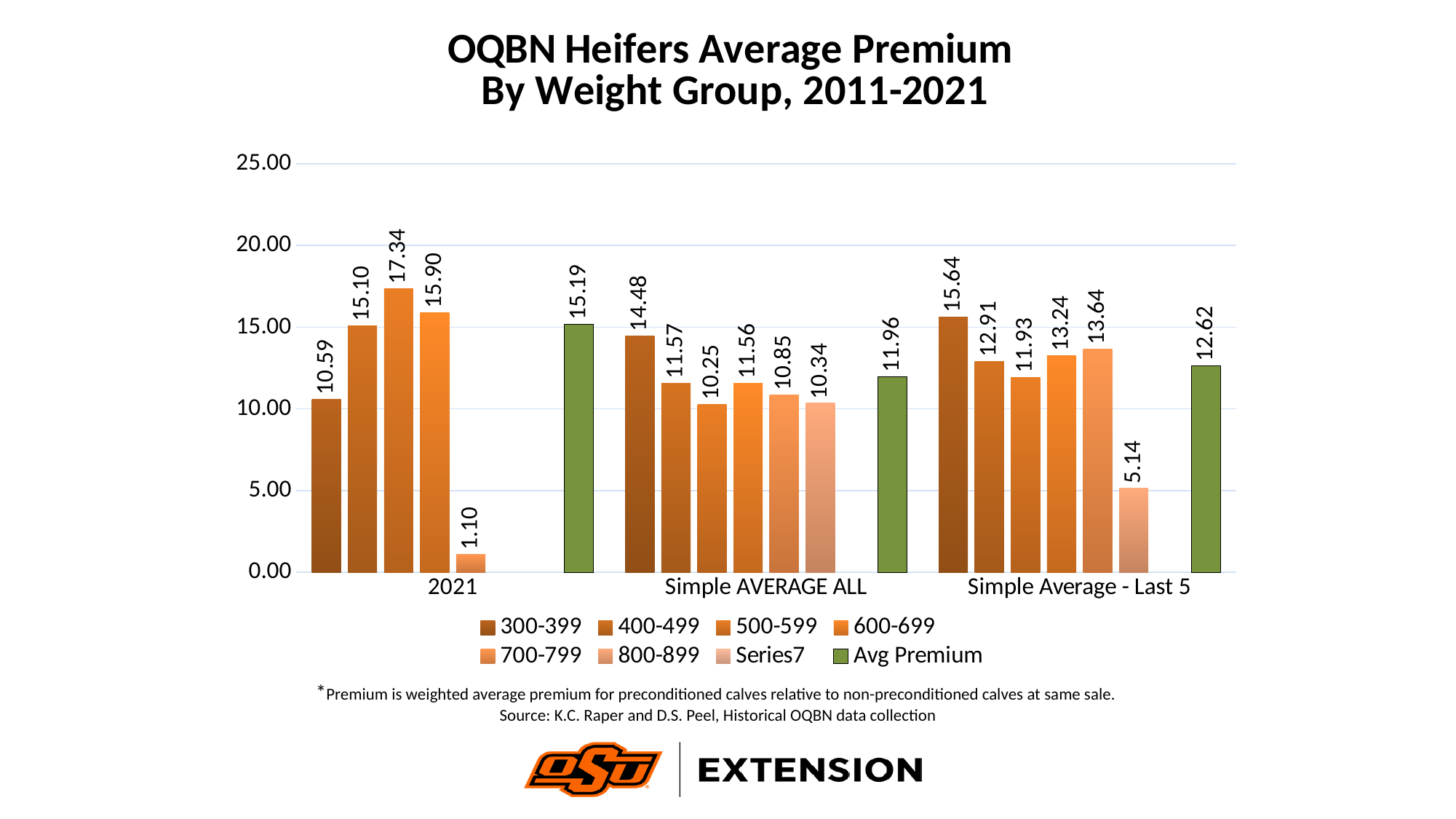
What is the Avg Premium value for Simple AVERAGE ALL? 11.96 What is the lowest value shown in the 2021 group? 1.10 What is the Avg Premium value for Simple Average - Last 5? 12.62 What kind of chart is shown on the slide? bar chart Which is larger: the 300-399 value for Simple AVERAGE ALL or the 300-399 value for Simple Average - Last 5? Simple Average - Last 5 What is the lowest value shown in the Simple Average - Last 5 group? 5.14 How many series does the legend list? 8 How many categories are shown on the x axis? 3 What is the highest value among the weight-group bars in the 2021 group? 17.34 What is the Avg Premium value for 2021? 15.19 Is the Avg Premium for Simple AVERAGE ALL greater or less than 15.00? less What is the difference between the Avg Premium for 2021 and the Avg Premium for Simple AVERAGE ALL? 3.23